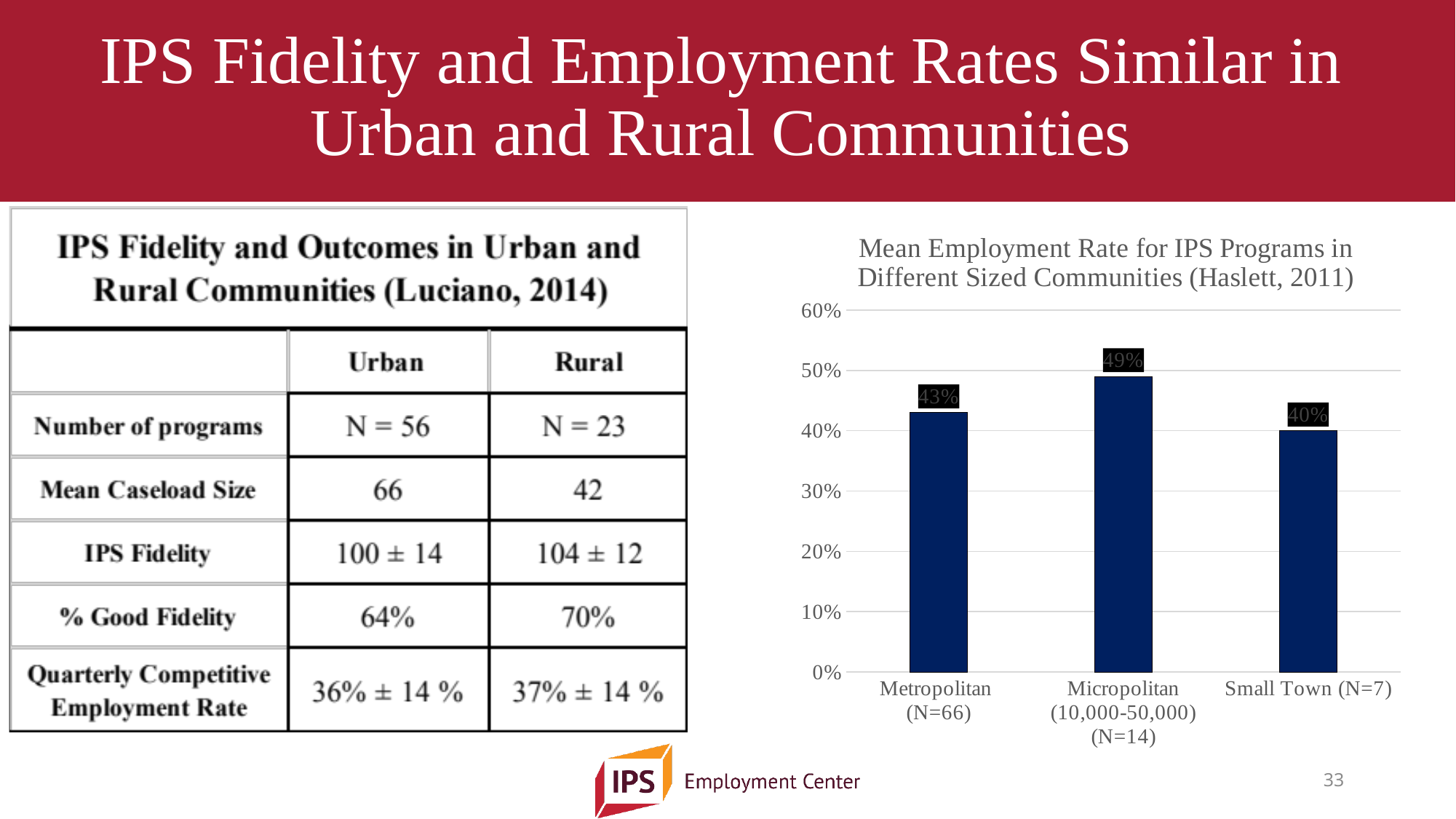
What is the title of the bar chart on the slide? Mean Employment Rate for IPS Programs in Different Sized Communities (Haslett, 2011) What type of chart is used to show the mean employment rate for IPS programs in different sized communities? Bar chart What is the mean employment rate for Micropolitan (10,000-50,000) (N=14) programs in the bar chart? 49% Which community size has the highest mean employment rate in the bar chart? Micropolitan (10,000-50,000) (N=14) Which community size has the lowest mean employment rate in the bar chart? Small Town (N=7) What is the mean employment rate for Metropolitan (N=66) programs in the bar chart? 43% How many community size categories are shown in the bar chart? 3 Is the mean employment rate for Micropolitan programs greater or less than 40%? greater In the bar chart, which has a higher mean employment rate, Metropolitan or Micropolitan programs? Micropolitan What is the difference in mean employment rate between Metropolitan and Small Town programs in the bar chart? 3% What is the difference in mean employment rate between Micropolitan and Small Town programs in the bar chart? 9% What is the mean employment rate for Small Town (N=7) programs in the bar chart? 40%